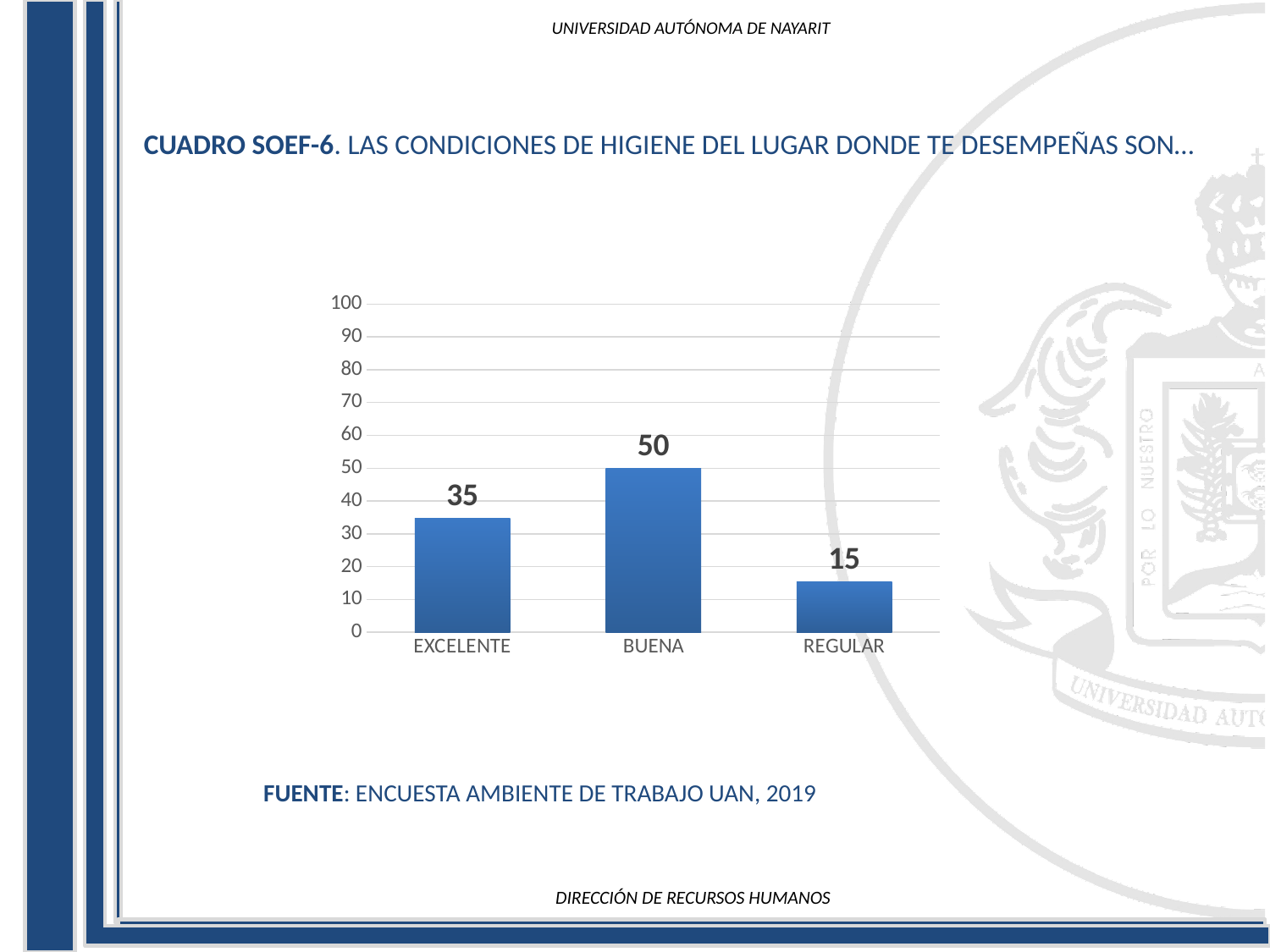
Which category has the lowest value? REGULAR Is the value for BUENA greater or less than 40? greater Which category has the highest value? BUENA What is the value for REGULAR? 15 Which is larger, the value for EXCELENTE or the value for REGULAR? EXCELENTE How many categories are shown on the x axis? 3 What is the value for EXCELENTE? 35 What is the difference between the values for BUENA and EXCELENTE? 15 What is the total of the three values shown in the chart? 100 What is the difference between the values for EXCELENTE and REGULAR? 20 What kind of chart is shown on the slide? bar chart What is the value for BUENA? 50